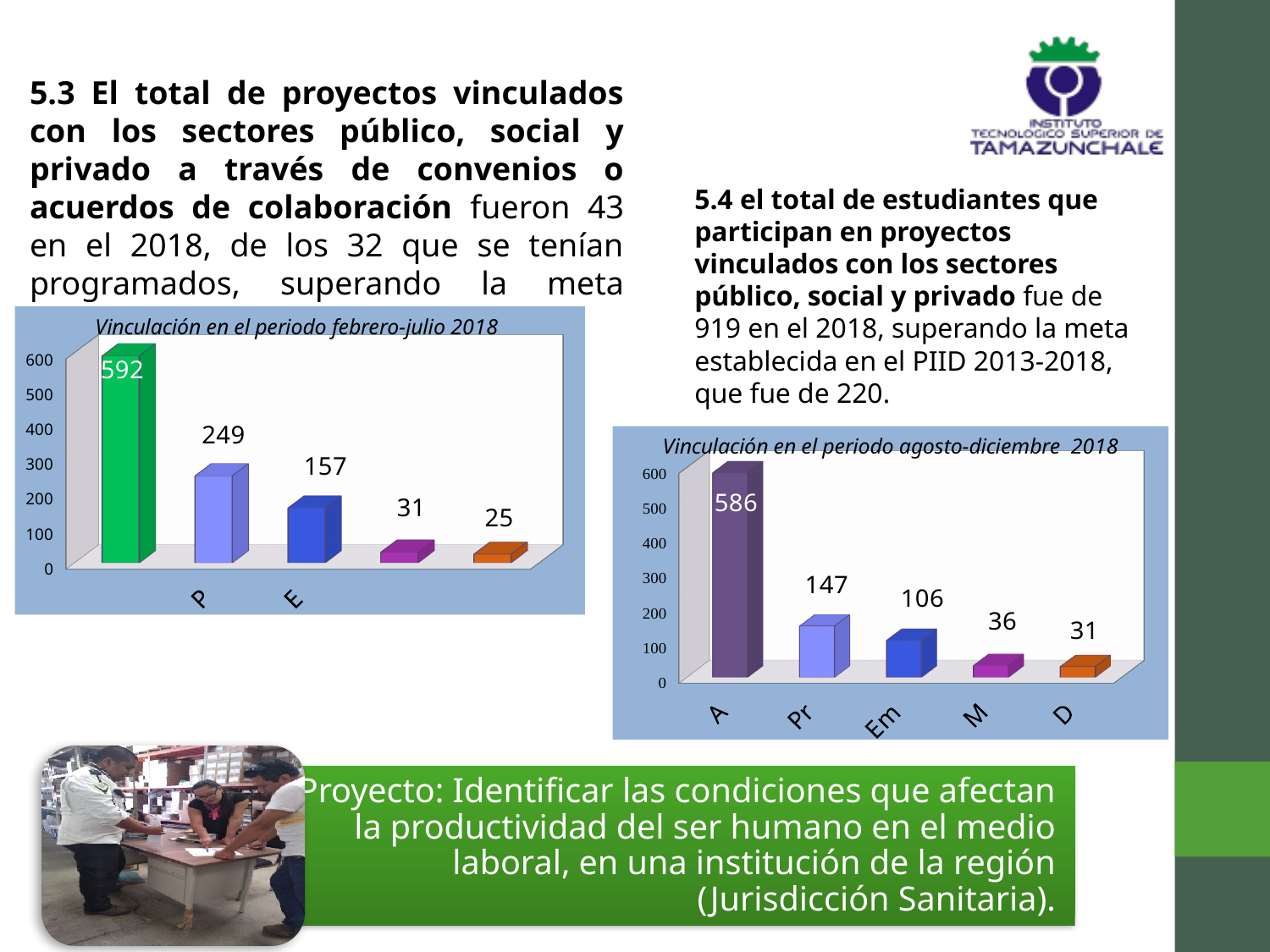
In the chart titled 'Vinculación en el periodo agosto-diciembre 2018', what is the value of the first (purple) bar? 586 In the chart titled 'Vinculación en el periodo agosto-diciembre 2018', which is larger: the fourth bar (36) or the fifth bar (31)? the fourth bar (36) In the chart titled 'Vinculación en el periodo febrero-julio 2018', what is the value of the first (green) bar? 592 In the chart titled 'Vinculación en el periodo febrero-julio 2018', how many bars are plotted? 5 In the chart titled 'Vinculación en el periodo febrero-julio 2018', what is the value of the last (orange) bar? 25 In the chart titled 'Vinculación en el periodo febrero-julio 2018', do the values rise or fall from left to right? fall In the chart titled 'Vinculación en el periodo agosto-diciembre 2018', what is the difference between the first bar (586) and the second bar (147)? 439 In the chart titled 'Vinculación en el periodo agosto-diciembre 2018', what is the value of the third (dark blue) bar? 106 What kind of chart is the one titled 'Vinculación en el periodo agosto-diciembre 2018'? bar chart In the chart titled 'Vinculación en el periodo febrero-julio 2018', what is the highest value shown? 592 In the chart titled 'Vinculación en el periodo febrero-julio 2018', what is the difference between the second bar (249) and the third bar (157)? 92 In the chart titled 'Vinculación en el periodo agosto-diciembre 2018', what is the lowest value shown? 31